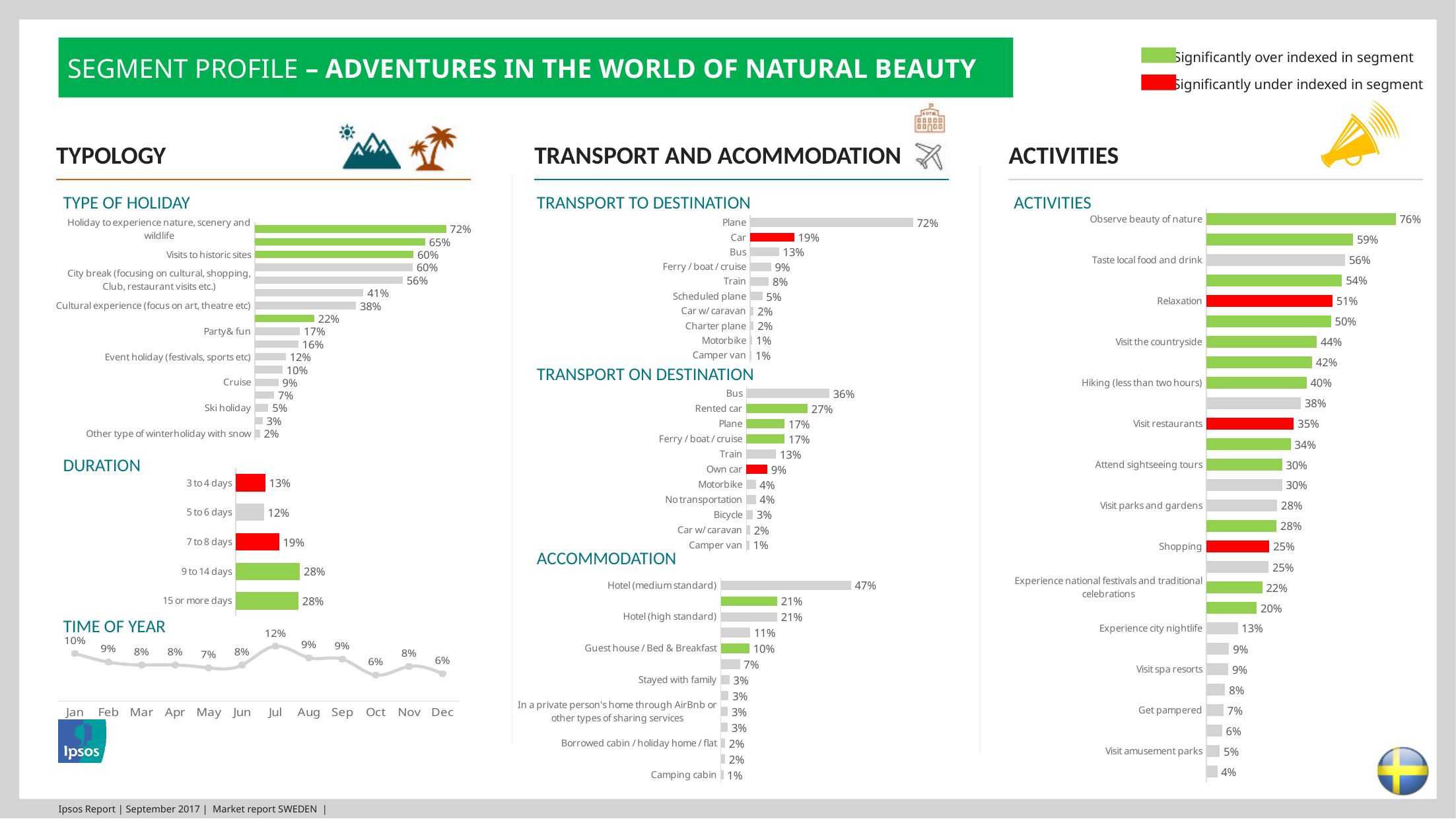
What type of chart is the Time of Year chart? Line chart According to the legend at the top right, what does a red bar indicate? Significantly under indexed in segment In the Transport on Destination chart, what is the difference between Bus and Own car? 27% In the Transport to Destination chart, which category has the highest value? Plane In the Time of Year chart, which month has the highest value? Jul In the Transport to Destination chart, what percentage is shown for Plane? 72% In the Accommodation chart, what is the value for Hotel (medium standard)? 47% In the Activities chart, what is the value for Shopping? 25% In the Transport on Destination chart, what is the value for Rented car? 27% In the Activities chart, what is the value for Observe beauty of nature? 76% How many duration categories are shown in the Duration chart? 5 In the Duration chart, which is larger: 7 to 8 days or 3 to 4 days? 7 to 8 days